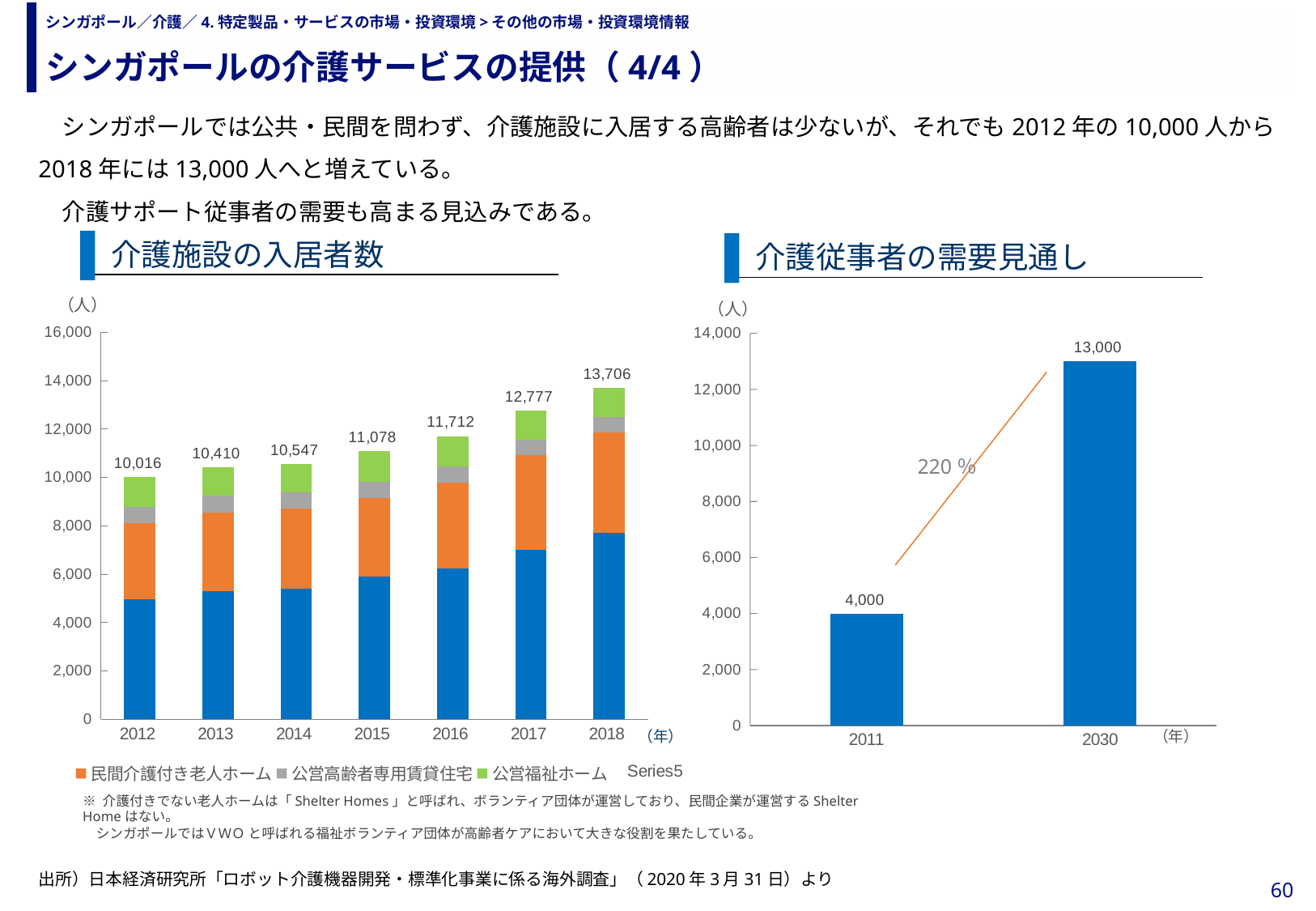
In the 介護施設の入居者数 chart, what is the total number of residents in 2018? 13,706 What kind of chart is the 介護施設の入居者数 chart? stacked bar chart In the 介護施設の入居者数 chart, how many years are shown on the x axis? 7 In the 介護施設の入居者数 chart, which year has the highest total? 2018 In the 介護施設の入居者数 chart, which year has the lowest total? 2012 In the 介護従事者の需要見通し chart, what is the difference between the 2030 value and the 2011 value? 9,000 In the 介護従事者の需要見通し chart, what is the value for 2030? 13,000 In the 介護施設の入居者数 chart, what is the total number of residents in 2012? 10,016 In the 介護施設の入居者数 chart, do the totals rise or fall from 2012 to 2018? rise In the 介護施設の入居者数 chart, is the total for 2015 greater or less than 12,000? less In the 介護施設の入居者数 chart, what is the difference between the 2018 total and the 2017 total? 929 In the 介護従事者の需要見通し chart, what percentage is printed next to the arrow between the two bars? 220 %